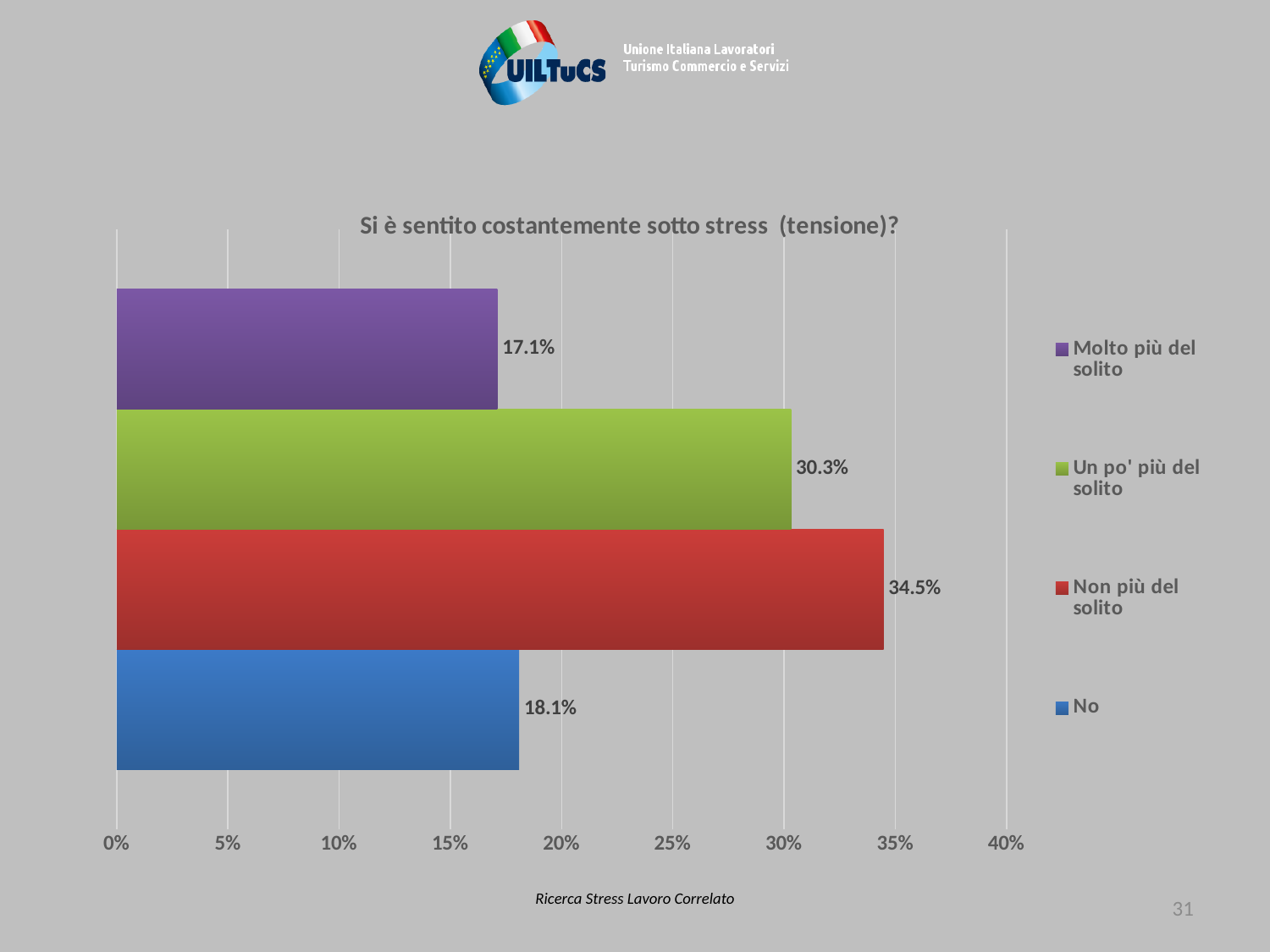
Which is larger, "No" or "Molto più del solito"? No What is the value for "No"? 18.1% What is the value for "Non più del solito"? 34.5% What is the value for "Un po' più del solito"? 30.3% What is the difference between "Non più del solito" and "Un po' più del solito"? 4.2% What is the title of the chart? Si è sentito costantemente sotto stress (tensione)? What kind of chart is shown on the slide? Bar chart How many categories are shown in the chart? 4 What is the value for "Molto più del solito"? 17.1% Which category has the lowest value? Molto più del solito Which category has the highest value? Non più del solito Is the value for "Un po' più del solito" greater or less than 25%? greater